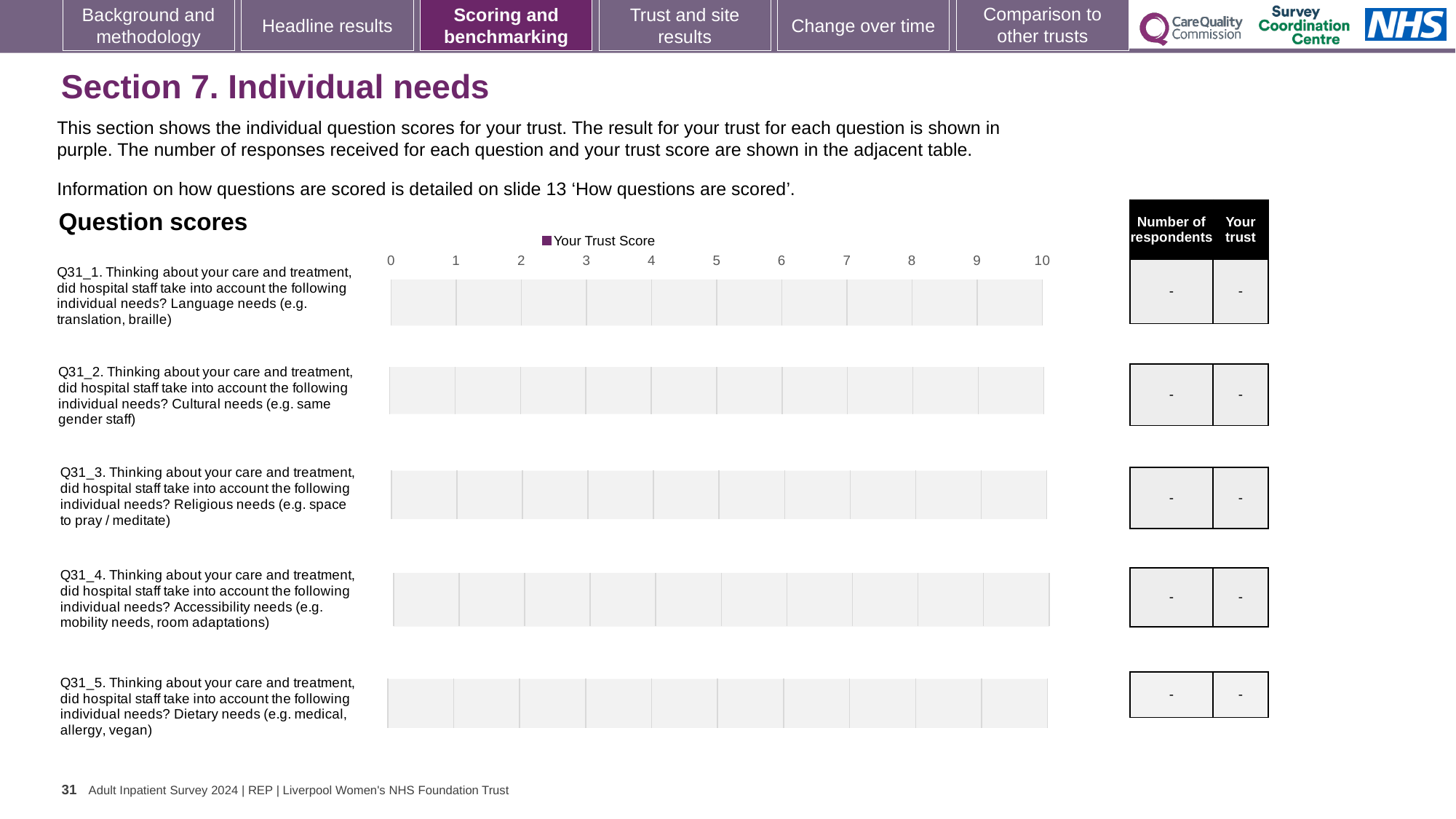
What is the name of the series shown in the legend above the question score charts? Your Trust Score How many question score charts (one per question) are shown on the slide? 5 What kind of chart is used for the question scores on this slide? bar chart In the adjacent table, what is the 'Your trust' value shown for Q31_1? - What is the highest value shown on the horizontal axis of the question score charts? 10 In the adjacent table, what is the 'Number of respondents' value shown for Q31_5? - How many series does the legend above the question score charts list? 1